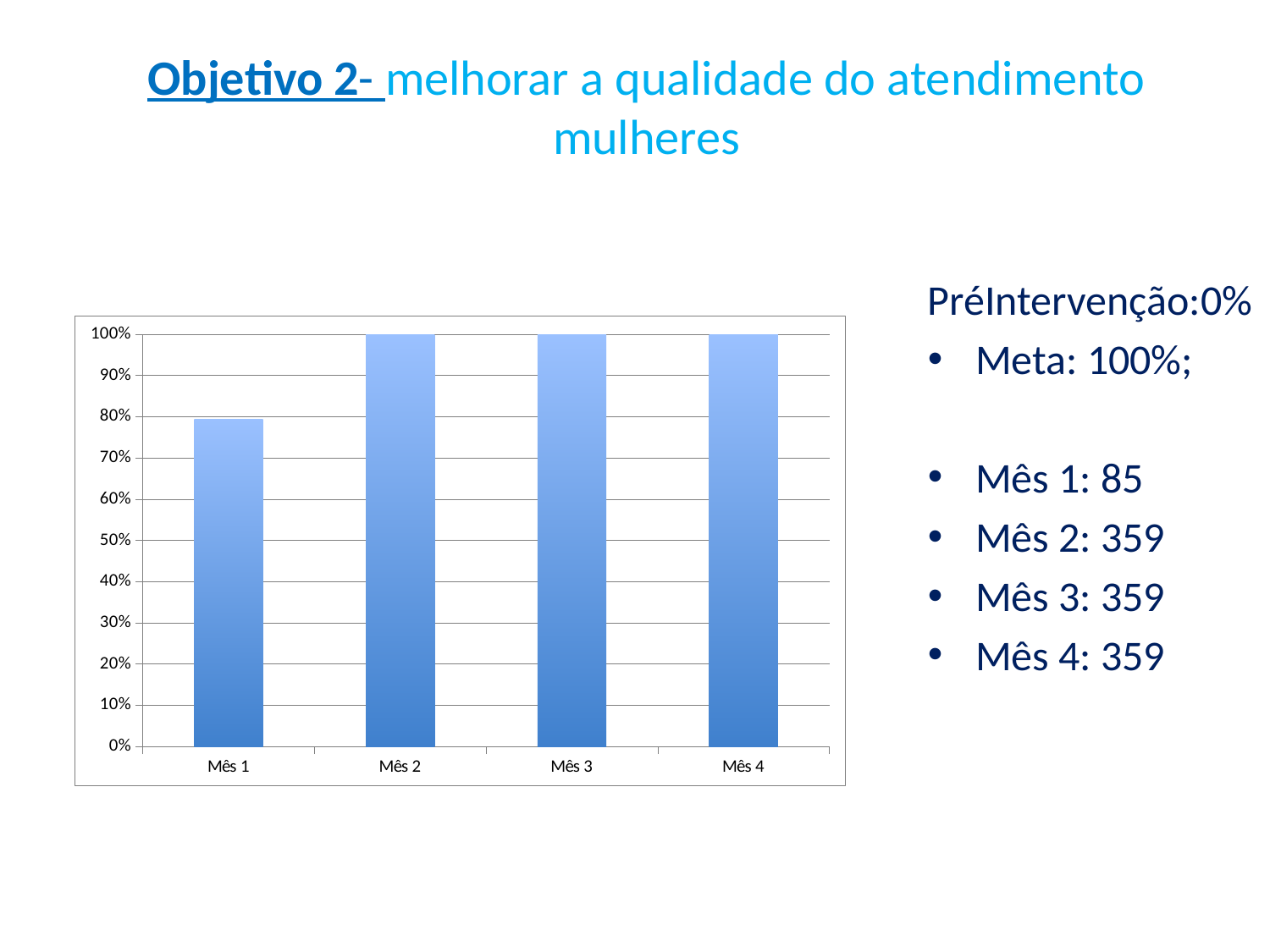
What kind of chart is shown on the slide? bar chart What is the value for Mês 4 in the chart? 100% What is the label of the first category on the x axis? Mês 1 Do the values rise or fall from Mês 1 to Mês 2? rise Which category has the lowest value in the chart? Mês 1 How many categories are plotted on the x axis of the chart? 4 Which is larger, the value for Mês 1 or the value for Mês 3? Mês 3 What is the value for Mês 2 in the chart? 100% Is the value for Mês 1 greater or less than 70%? greater What is the highest value shown on the y axis of the chart? 100%